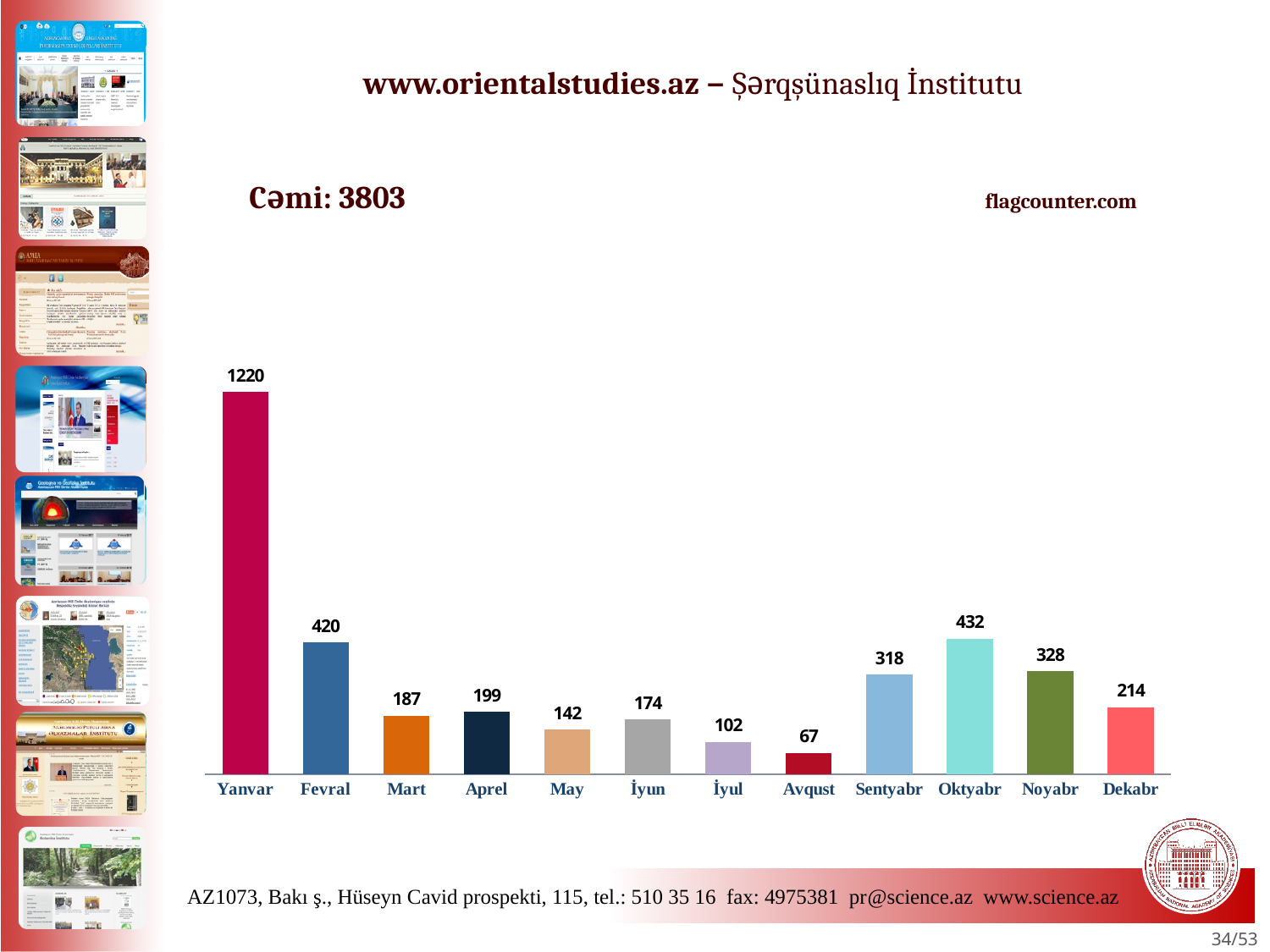
What kind of chart is shown on the slide? bar chart Which month has the highest value? Yanvar Which is larger, the value for May or the value for İyun? İyun What is the difference between the values for Oktyabr and Sentyabr? 114 What is the value for Yanvar? 1220 How many months are shown on the chart? 12 Which is larger, the value for Noyabr or the value for Dekabr? Noyabr What total (Cəmi) is stated on the slide? 3803 What is the value for Avqust? 67 Which month has the lowest value? Avqust What is the value for Oktyabr? 432 What is the difference between the values for Fevral and Mart? 233